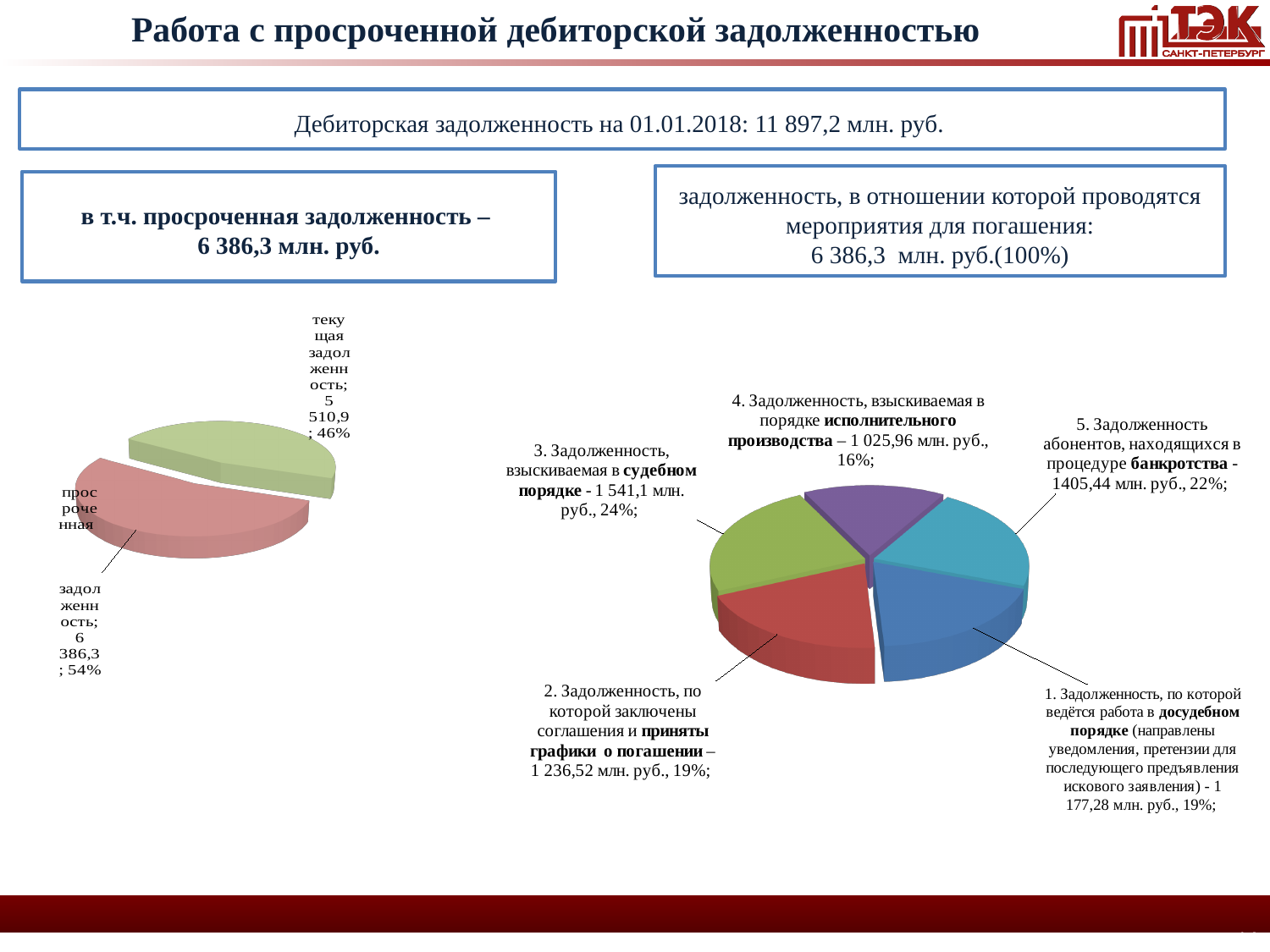
In the right pie chart, what share does задолженность абонентов, находящихся в процедуре банкротства have? 22% In the left pie chart, what is the difference between просроченная задолженность and текущая задолженность? 875,4 In the right pie chart, what is the difference between the value for судебном порядке and the value for исполнительного производства? 515,14 млн. руб. How many slices does the right pie chart have? 5 In the right pie chart, what is the value for задолженность, по которой ведётся работа в досудебном порядке? 1 177,28 млн. руб. In the right pie chart, which category has the smallest value? 4. Задолженность, взыскиваемая в порядке исполнительного производства In the right pie chart, which is larger: the value for банкротства or the value for приняты графики о погашении? банкротства In the right pie chart, what is the value for задолженность, взыскиваемая в судебном порядке? 1 541,1 млн. руб. In the left pie chart, what share does текущая задолженность have? 46% In the left pie chart, what is the value for просроченная задолженность? 6 386,3 What type of chart is the left chart on the slide? Pie chart In the right pie chart, which category has the largest value? 3. Задолженность, взыскиваемая в судебном порядке